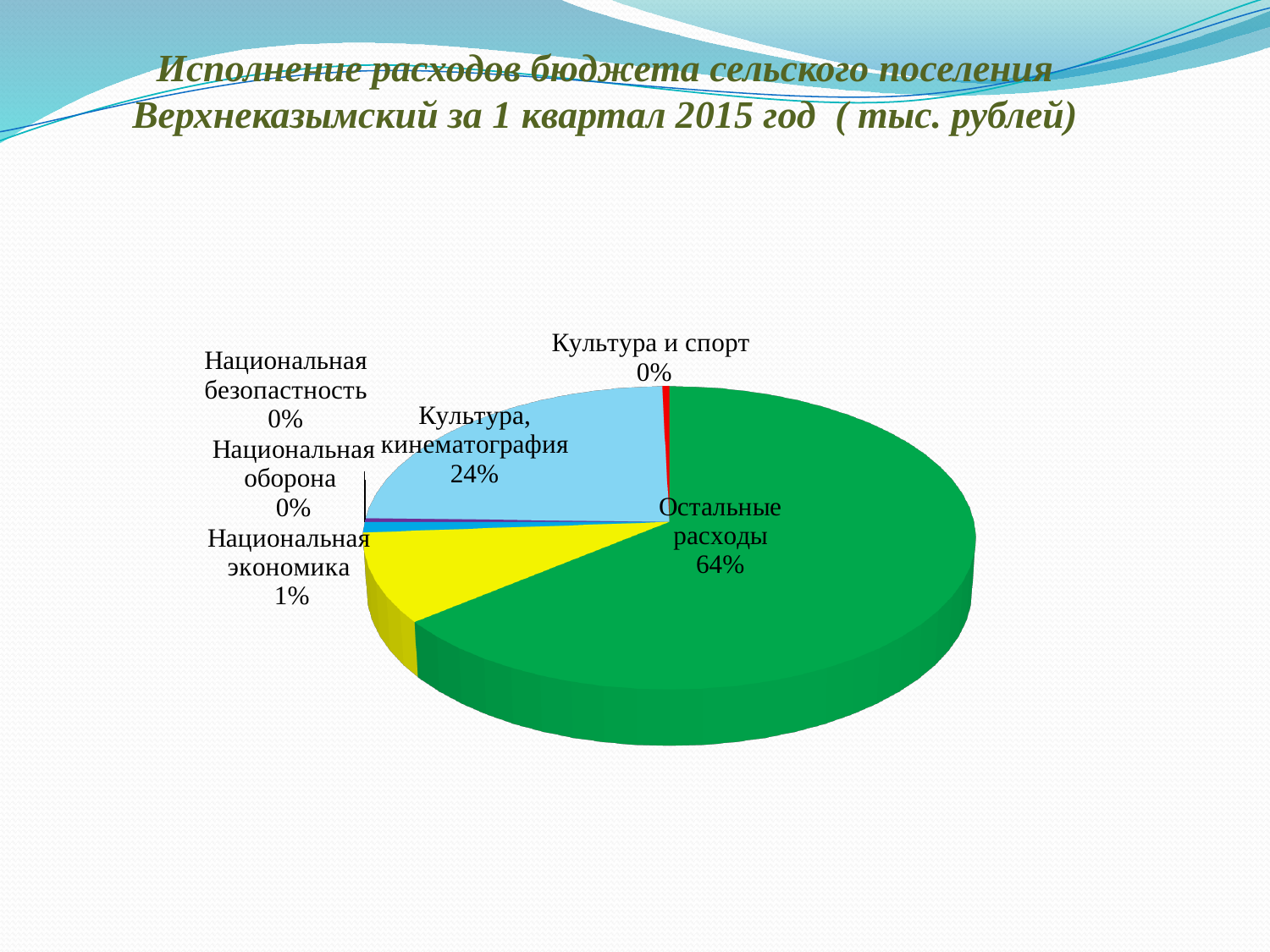
By how many percentage points does "Остальные расходы" exceed "Культура, кинематография"? 40 percentage points Which category has the largest share of the pie? Остальные расходы What percentage is shown for "Национальная оборона"? 0% Which is larger: "Остальные расходы" or "Культура, кинематография"? Остальные расходы What kind of chart is shown on the slide? Pie chart What percentage is shown for "Культура, кинематография"? 24% What percentage is shown for "Культура и спорт"? 0% Which is larger: "Культура, кинематография" or "Национальная экономика"? Культура, кинематография What share of the pie does "Остальные расходы" take? 64% What percentage is shown for "Национальная экономика"? 1% What period does the chart title say the budget expenditures cover? 1 квартал 2015 год What colour is the slice for "Остальные расходы"? Green